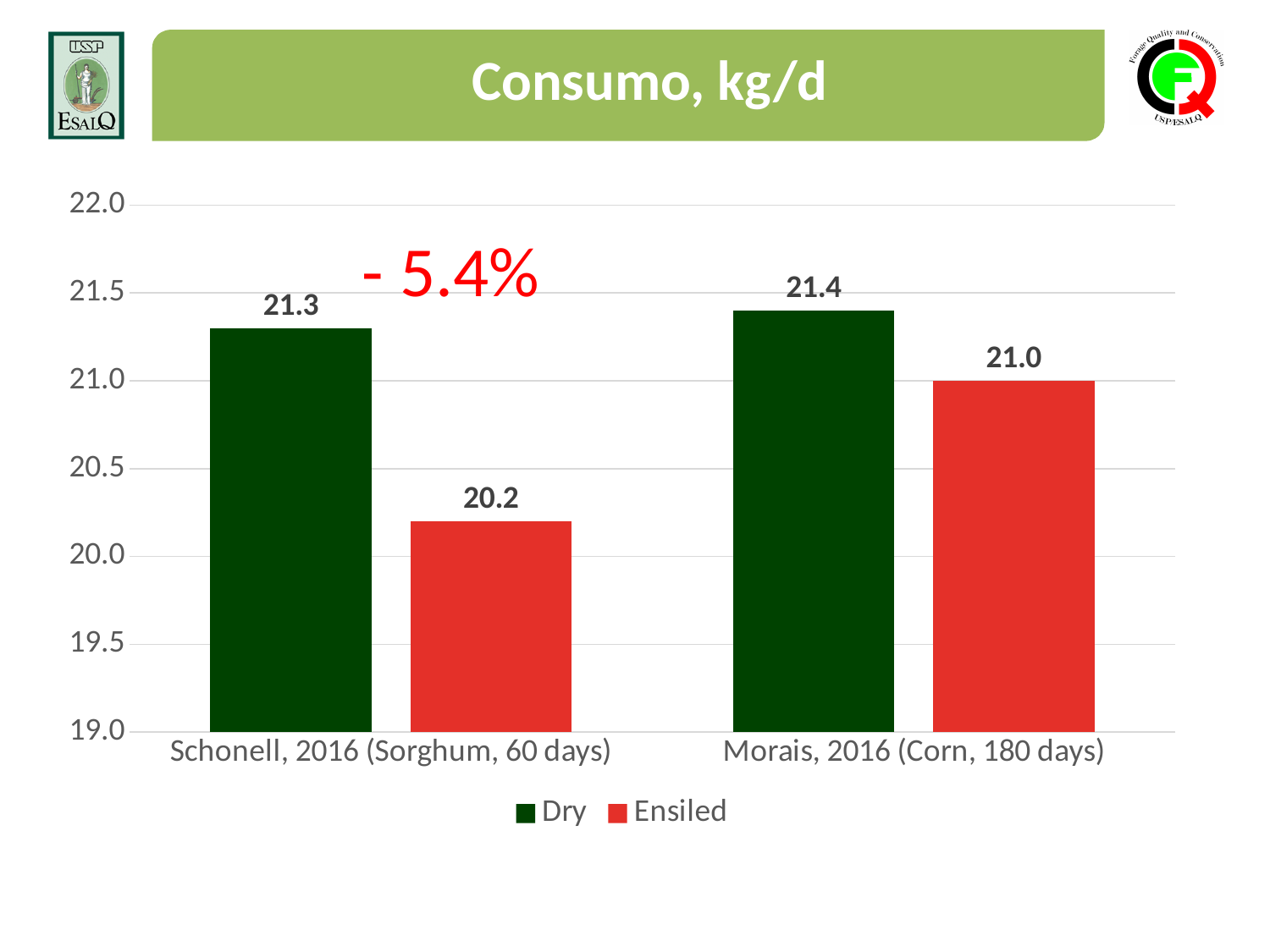
What is the Ensiled value for Schonell, 2016 (Sorghum, 60 days)? 20.2 What is the Ensiled value for Morais, 2016 (Corn, 180 days)? 21.0 What kind of chart is shown on the slide? Bar chart What is the Dry value for Morais, 2016 (Corn, 180 days)? 21.4 Which is larger for Morais, 2016 (Corn, 180 days): the Dry value or the Ensiled value? Dry What is the Dry value for Schonell, 2016 (Sorghum, 60 days)? 21.3 What is the difference between the Dry and Ensiled values for Schonell, 2016 (Sorghum, 60 days)? 1.1 How many series does the legend list? 2 What is the difference between the Dry and Ensiled values for Morais, 2016 (Corn, 180 days)? 0.4 Which bar has the lowest value on the chart? Ensiled, Schonell, 2016 (Sorghum, 60 days) What is the title of the chart? Consumo, kg/d How many categories are shown on the x axis? 2